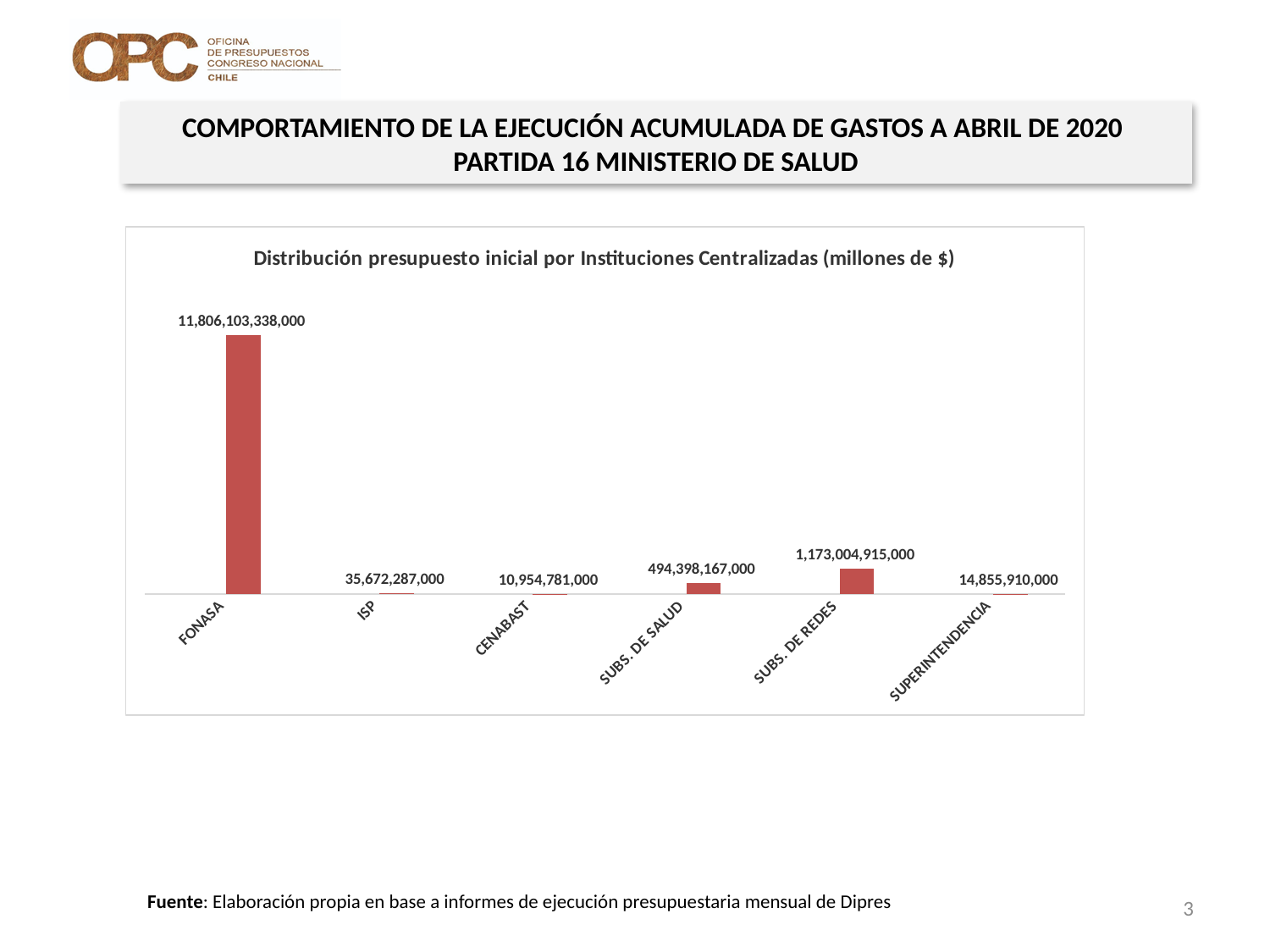
Which institution has the highest value? FONASA What kind of chart is shown on the slide? Bar chart Which is larger, the value for ISP or the value for SUPERINTENDENCIA? ISP How many institutions are shown in the chart? 6 What is the value for SUBS. DE REDES? 1,173,004,915,000 What is the value for FONASA? 11,806,103,338,000 Which institution has the lowest value? CENABAST What is the value for SUPERINTENDENCIA? 14,855,910,000 What is the difference between SUBS. DE REDES and SUBS. DE SALUD? 678,606,748,000 What is the title of the chart? Distribución presupuesto inicial por Instituciones Centralizadas (millones de $) What is the value for CENABAST? 10,954,781,000 What is the difference between ISP and CENABAST? 24,717,506,000